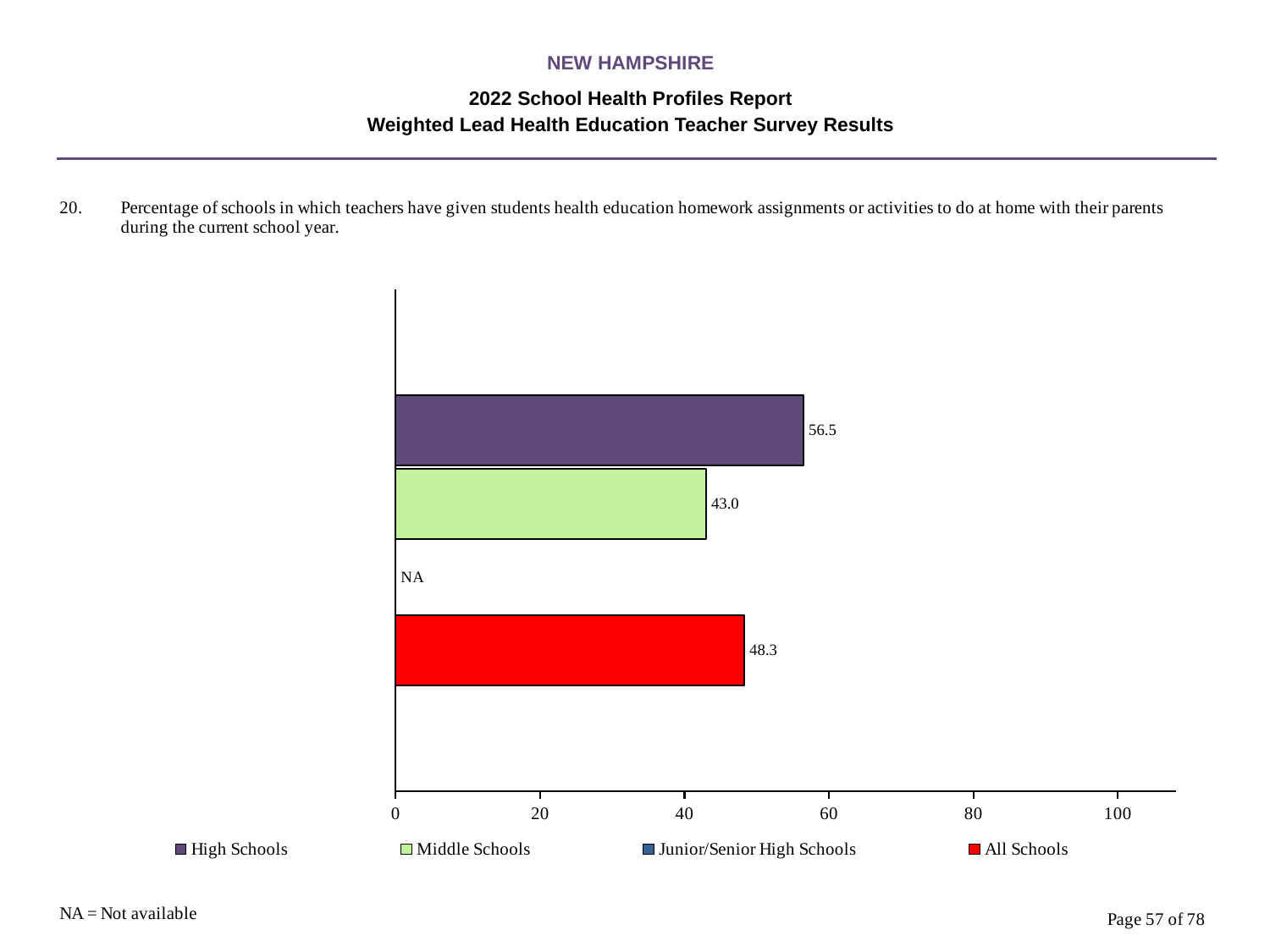
How many series does the legend list? 4 Which school type with a plotted value has the lowest value? Middle Schools Is the value for Middle Schools greater or less than 40? greater What is the difference between the High Schools value and the Middle Schools value? 13.5 What kind of chart is shown on the slide? Bar chart What is the value for All Schools? 48.3 What is the value for Middle Schools? 43.0 What is the value for High Schools? 56.5 What is shown for Junior/Senior High Schools? NA What is the difference between the All Schools value and the Middle Schools value? 5.3 Which is larger, the value for High Schools or the value for All Schools? High Schools Which school type has the highest value? High Schools